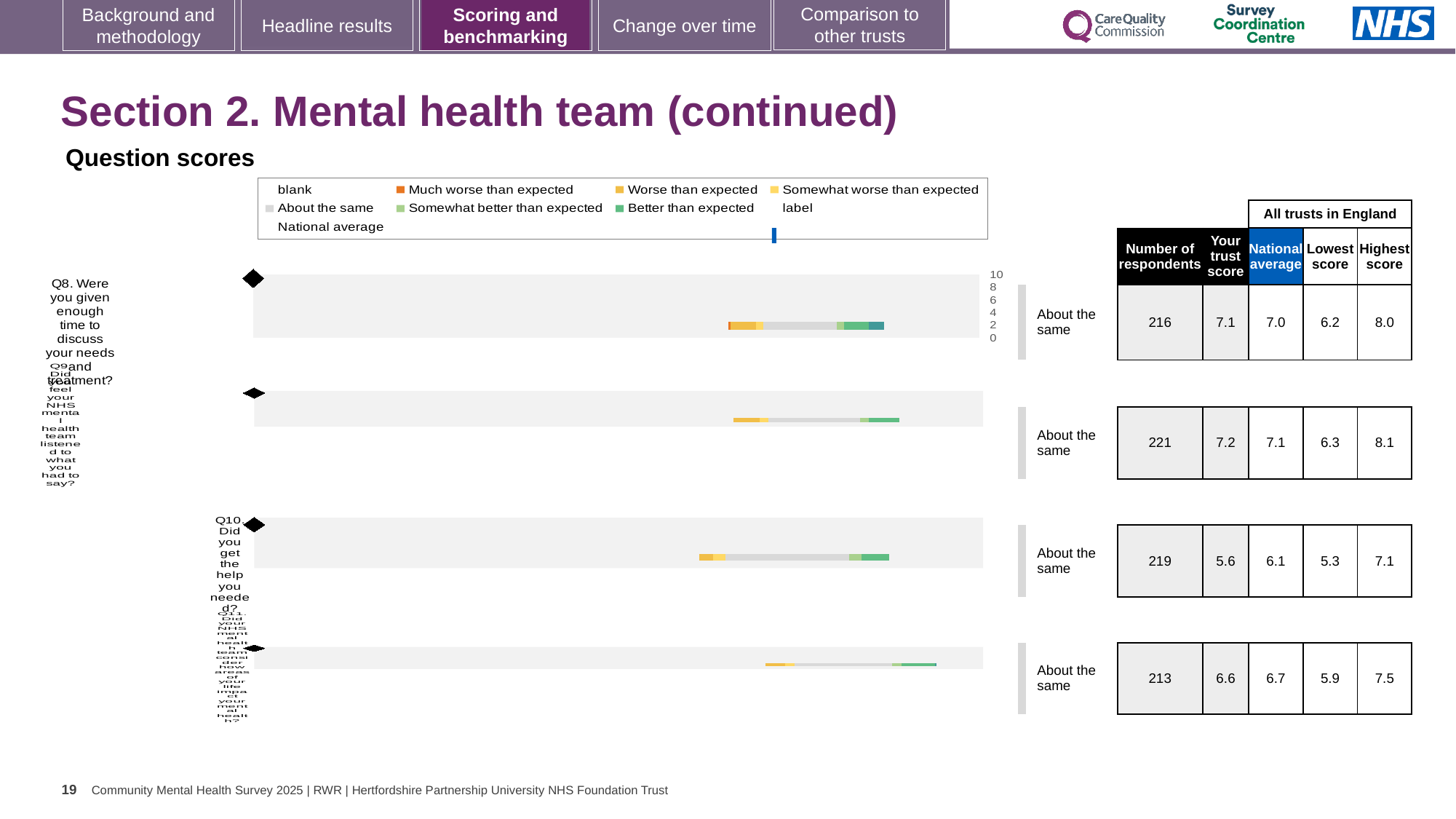
Which question has the highest 'Your trust score'? Q9 What benchmark category is shown next to the Q8 chart? About the same How many questions (Q8 to Q11) are charted on this slide? 4 For Q10, what is the difference between the national average and the trust score? 0.5 For Q9, what is the difference between the highest score and the lowest score across all trusts in England? 1.8 What is the national average score for Q10? 6.1 Which question has the lowest 'Your trust score'? Q10 What kind of chart is used to show the question scores on this slide? bar chart What is the 'Your trust score' value for Q9? 7.2 What is the highest score across all trusts in England for Q11? 7.5 For Q8, which is larger: the trust score or the national average? the trust score (7.1) For Q8, how many respondents are shown in the table? 216